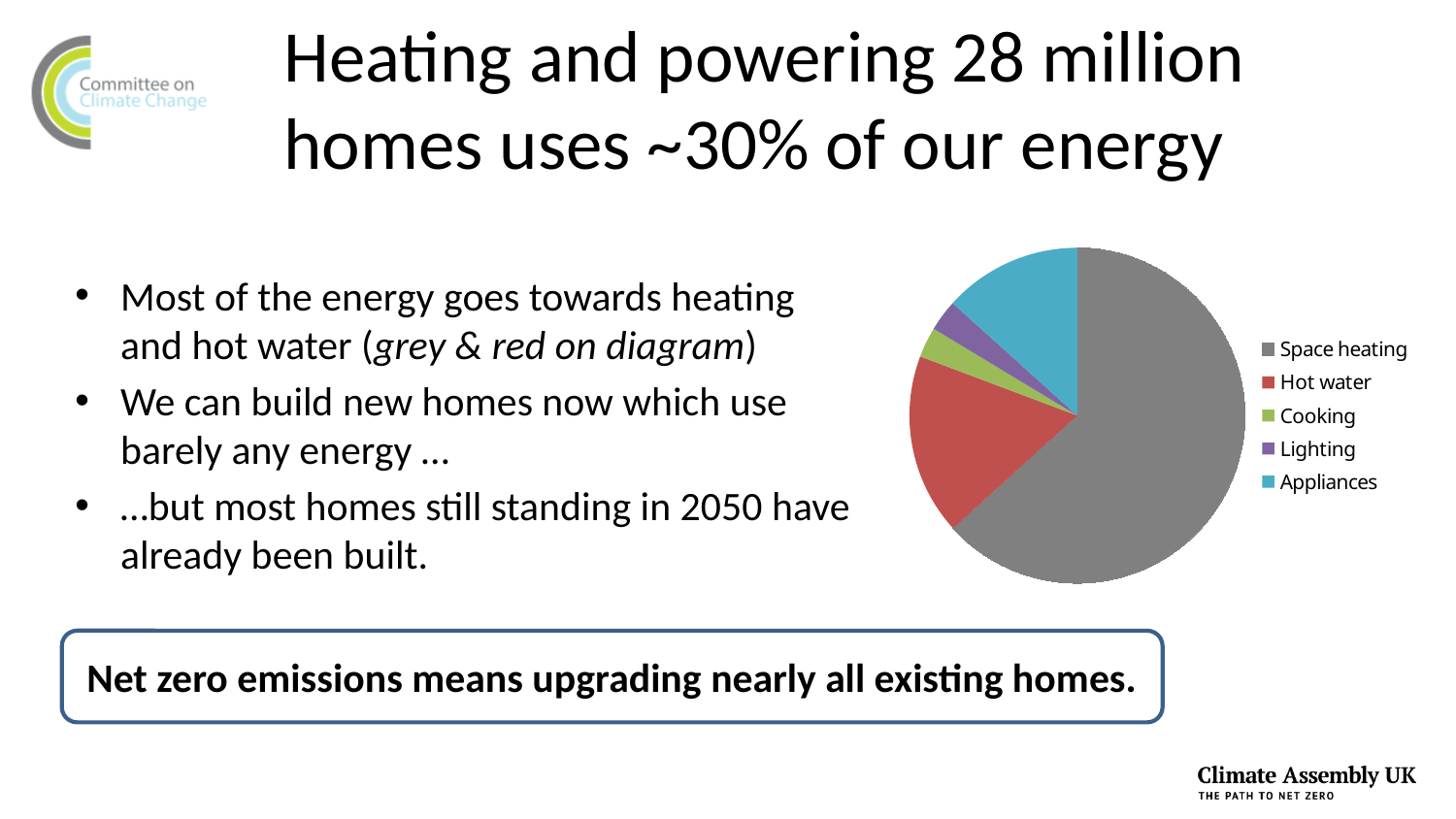
Which slice is larger, Hot water or Lighting? Hot water What colour represents Space heating in the pie chart? Grey Which slice is larger, Appliances or Cooking? Appliances Which category has the largest slice of the pie chart? Space heating Which category is shown in red in the pie chart? Hot water What kind of chart is shown on the slide? Pie chart How many categories does the pie chart show? 5 How many entries does the legend of the pie chart list? 5 Which slice is larger, Hot water or Appliances? Hot water